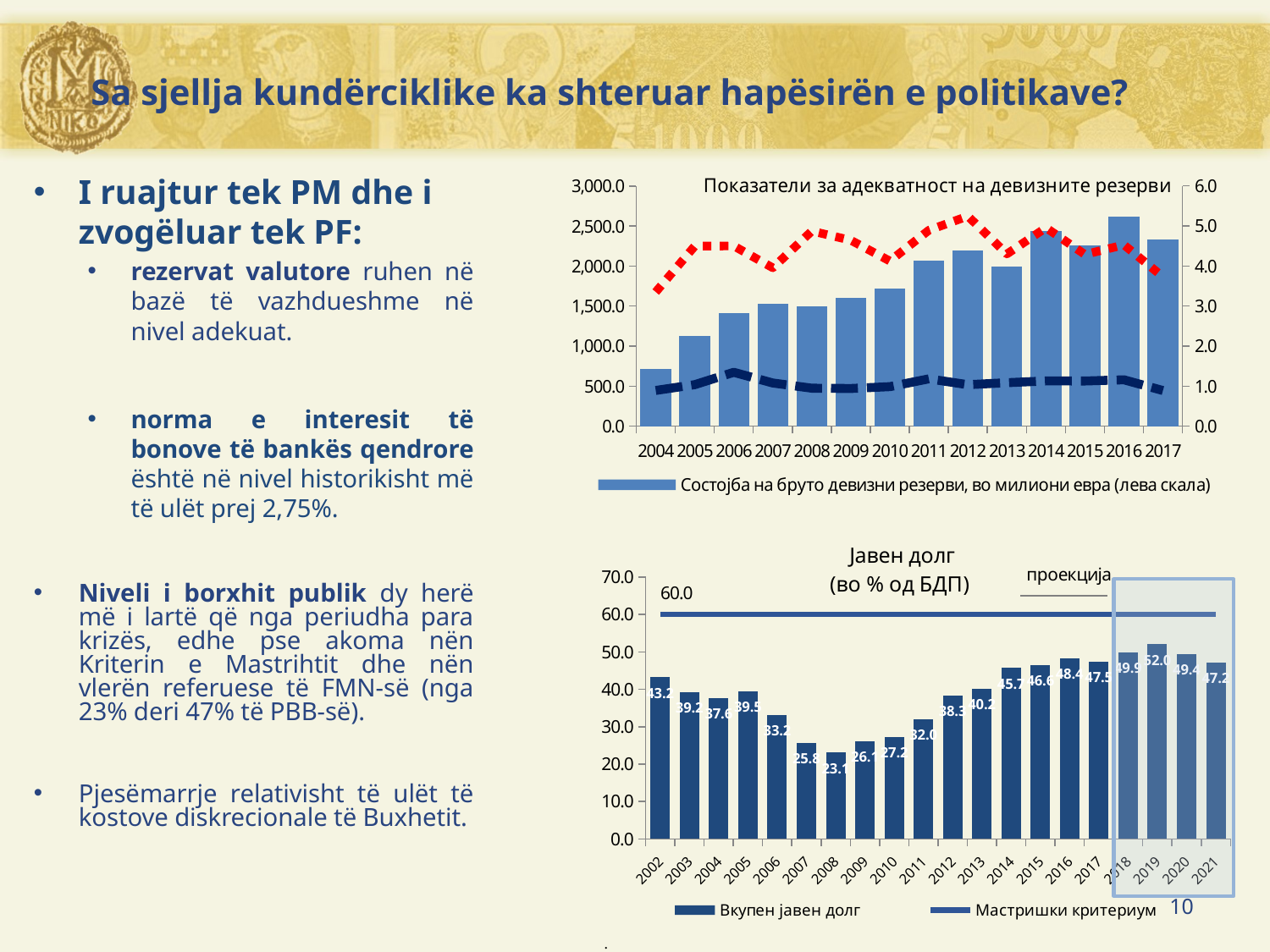
In the bottom chart (Јавен долг), what is the difference between the values for 2019 and 2008? 28.9 In the bottom chart (Јавен долг), which year has the lowest public debt value? 2008 In the bottom chart (Јавен долг), at what level is the Мастришки критериум line drawn? 60.0 In the top chart (Показатели за адекватност на девизните резерви), is the bar value for 2004 greater or less than 1,000.0? less In the top chart (Показатели за адекватност на девизните резерви), which year has the tallest bar? 2016 In the bottom chart (Јавен долг), how many years are shown on the x axis? 20 In the bottom chart (Јавен долг), which year has the larger value, 2002 or 2017? 2017 In the top chart (Показатели за адекватност на девизните резерви), how many years are shown on the x axis? 14 In the bottom chart (Јавен долг), what is the value for 2008? 23.1 In the bottom chart (Јавен долг), what is the value for 2019? 52.0 In the bottom chart (Јавен долг), which year has the highest public debt value? 2019 In the bottom chart (Јавен долг), how many series does the legend list? 2